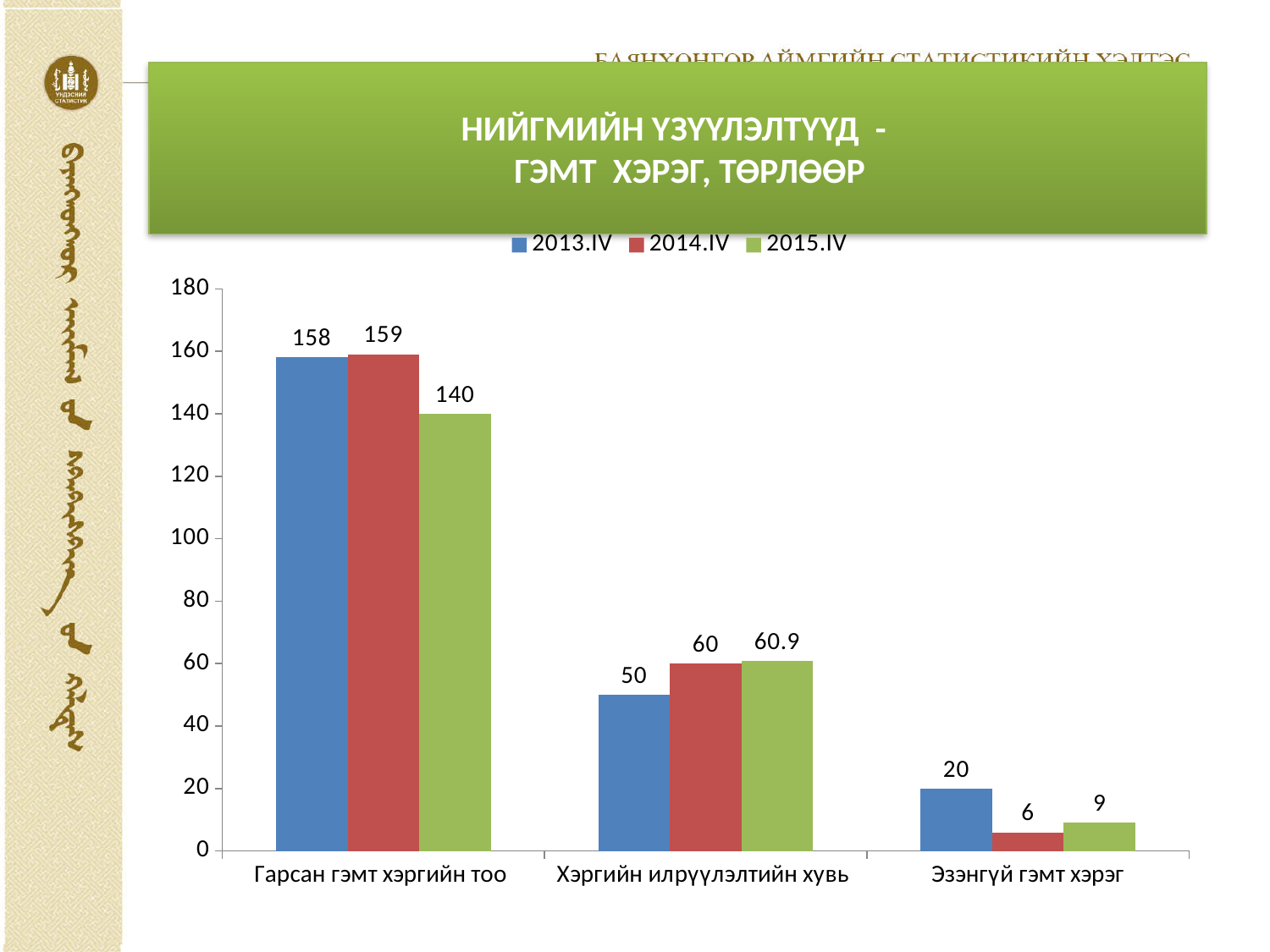
How many series does the legend list? 3 What is the maximum value shown on the vertical axis? 180 Which series has the highest value in the category Гарсан гэмт хэргийн тоо? 2014.IV What kind of chart is shown on the slide? bar chart What is the difference between the 2014.IV and 2015.IV values for Гарсан гэмт хэргийн тоо? 19 What is the value for 2014.IV in the category Эзэнгүй гэмт хэрэг? 6 What is the value for 2015.IV in the category Хэргийн илрүүлэлтийн хувь? 60.9 Which series has the lowest value in the category Эзэнгүй гэмт хэрэг? 2014.IV How many categories are shown on the x axis? 3 Which is larger for Эзэнгүй гэмт хэрэг: the 2013.IV value or the 2015.IV value? 2013.IV Is the 2015.IV value for Гарсан гэмт хэргийн тоо greater or less than 160? less What is the value for 2013.IV in the category Гарсан гэмт хэргийн тоо? 158